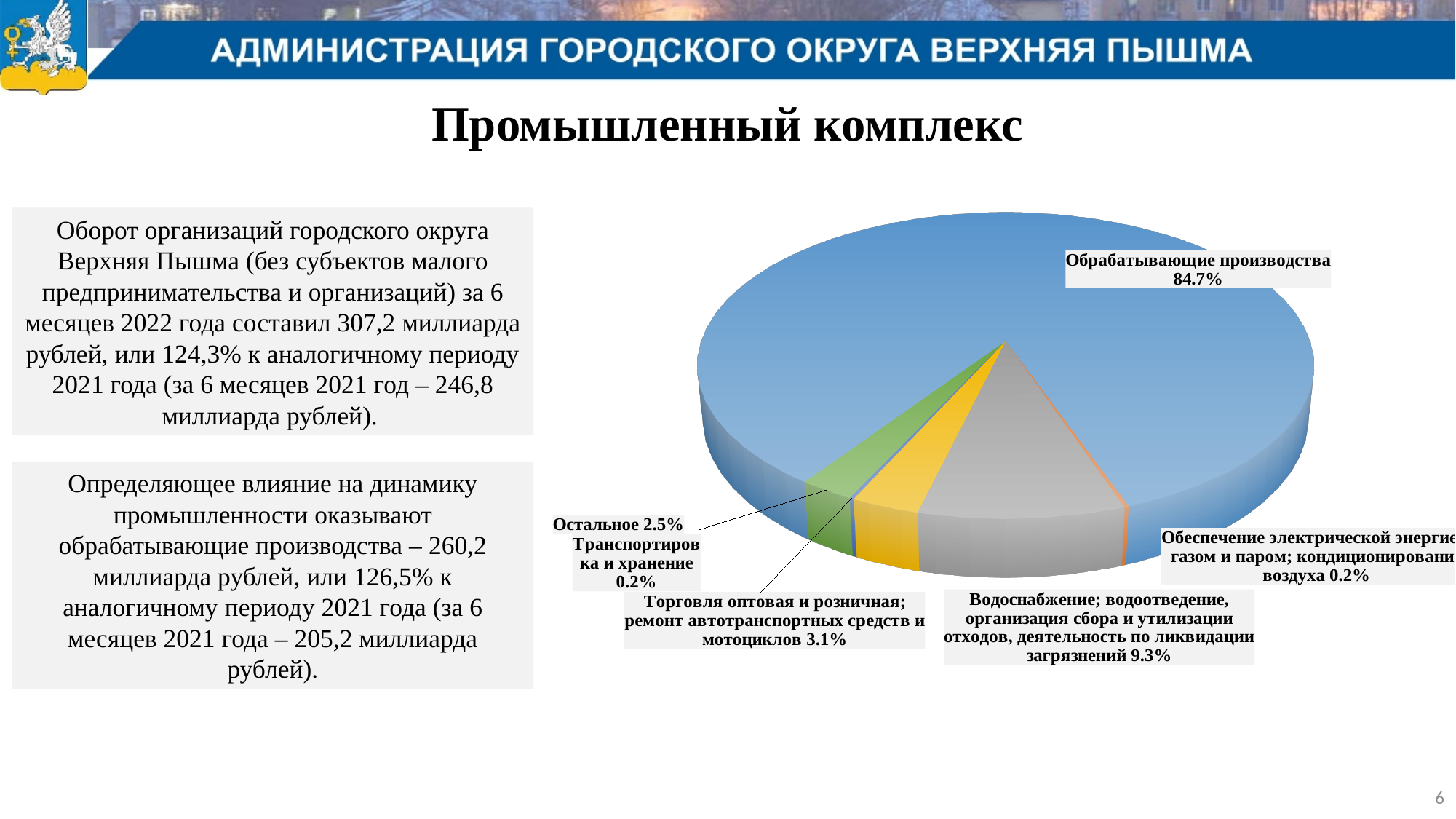
What colour is the slice for "Обрабатывающие производства"? blue What kind of chart is shown on the slide? pie chart What is the combined share of "Торговля оптовая и розничная; ремонт автотранспортных средств и мотоциклов" and "Остальное"? 5.6% What share of the pie does "Водоснабжение; водоотведение, организация сбора и утилизации отходов, деятельность по ликвидации загрязнений" have? 9.3% What is the difference in percentage points between "Обрабатывающие производства" and "Водоснабжение; водоотведение, организация сбора и утилизации отходов, деятельность по ликвидации загрязнений"? 75.4 Which category has the largest share of the pie? Обрабатывающие производства What share of the pie does "Торговля оптовая и розничная; ремонт автотранспортных средств и мотоциклов" have? 3.1% What share of the pie does "Транспортировка и хранение" have? 0.2% How many slices does the pie chart have? 6 Which is larger: the share for "Торговля оптовая и розничная; ремонт автотранспортных средств и мотоциклов" or the share for "Остальное"? Торговля оптовая и розничная; ремонт автотранспортных средств и мотоциклов What share of the pie does "Остальное" have? 2.5% What share of the pie does "Обрабатывающие производства" have? 84.7%